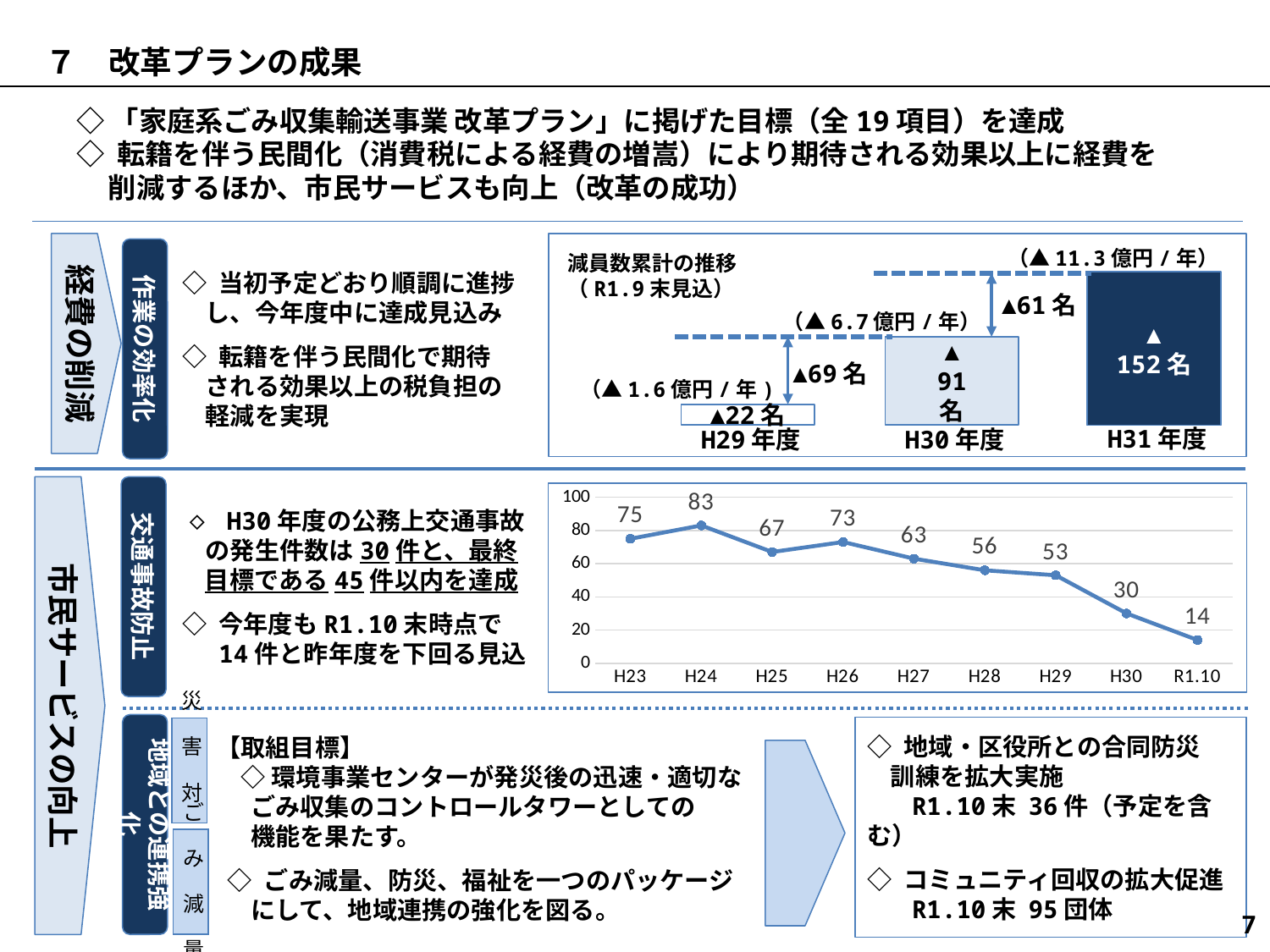
What kind of chart is the chart on the right showing values from H23 to R1.10? line chart In the line chart on the right, what is the value for R1.10? 14 In the line chart on the right, what is the value for H30? 30 In the line chart on the right, what is the value for H24? 83 In the line chart on the right, do the values generally rise or fall from H24 to R1.10? fall In the chart titled 減員数累計の推移, which year has the largest value? H31年度 In the line chart on the right, which category has the highest value? H24 In the line chart on the right, how many data points are plotted? 9 In the line chart on the right, what is the difference between the values for H29 and H30? 23 In the chart titled 減員数累計の推移, what is the value shown for H30年度? ▲91名 In the line chart on the right, which category has the lowest value? R1.10 In the line chart on the right, which is larger, the value for H25 or the value for H26? H26